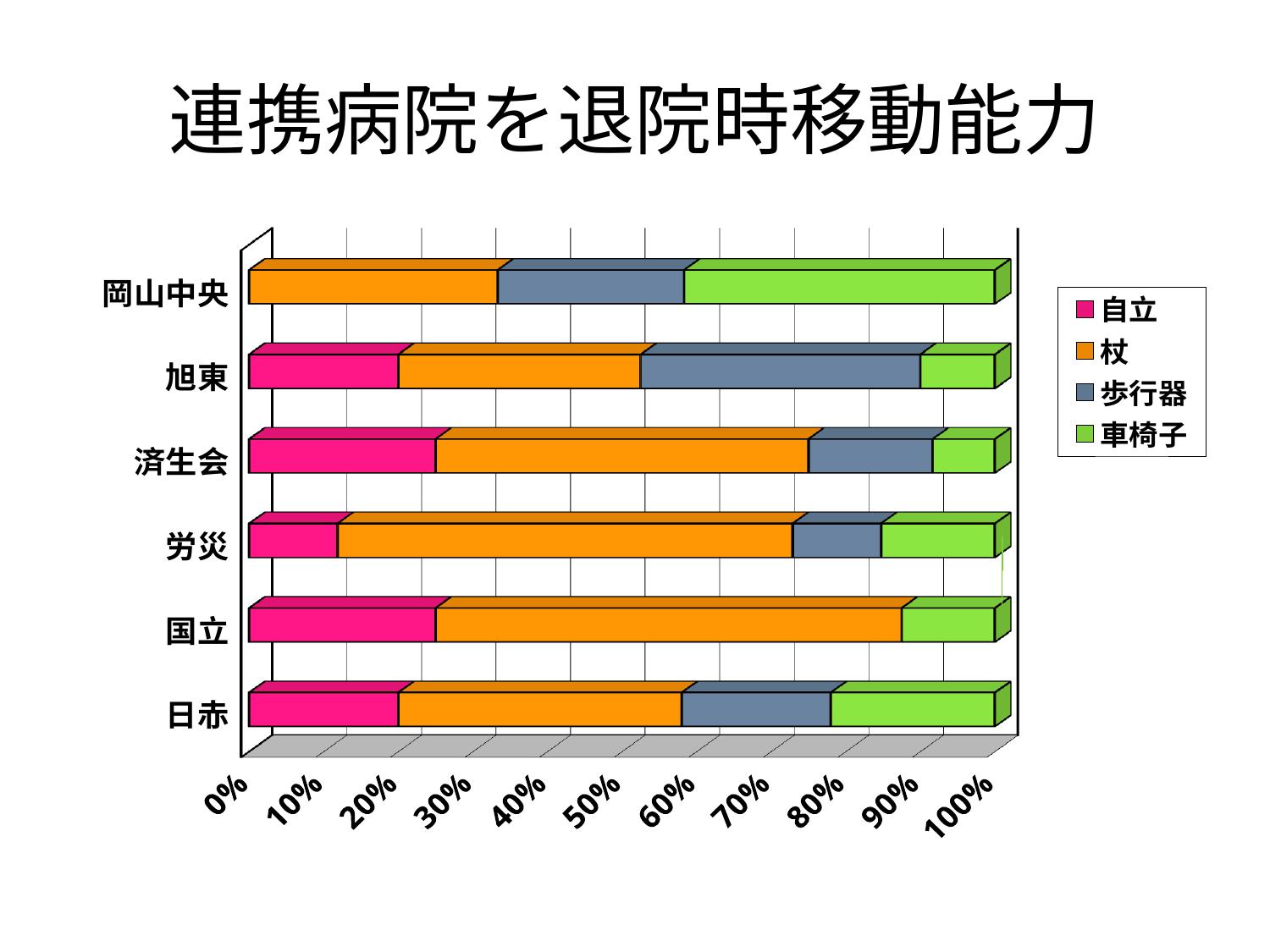
Which is larger, the 杖 share for 労災 or the 杖 share for 日赤? 労災 Which hospital has the largest 歩行器 share? 旭東 Which series is shown in green in the legend? 車椅子 What is the title of the chart? 連携病院を退院時移動能力 Is the 車椅子 share for 旭東 greater or less than 20%? less Which hospital has the largest 車椅子 share? 岡山中央 How many series does the legend list? 4 How many hospitals (categories) are plotted on the chart? 6 Which hospital's bar has no 歩行器 segment? 国立 Which hospital's bar has no 自立 segment? 岡山中央 Is the 杖 share for 労災 greater or less than 50%? greater What kind of chart is shown on the slide? Stacked bar chart